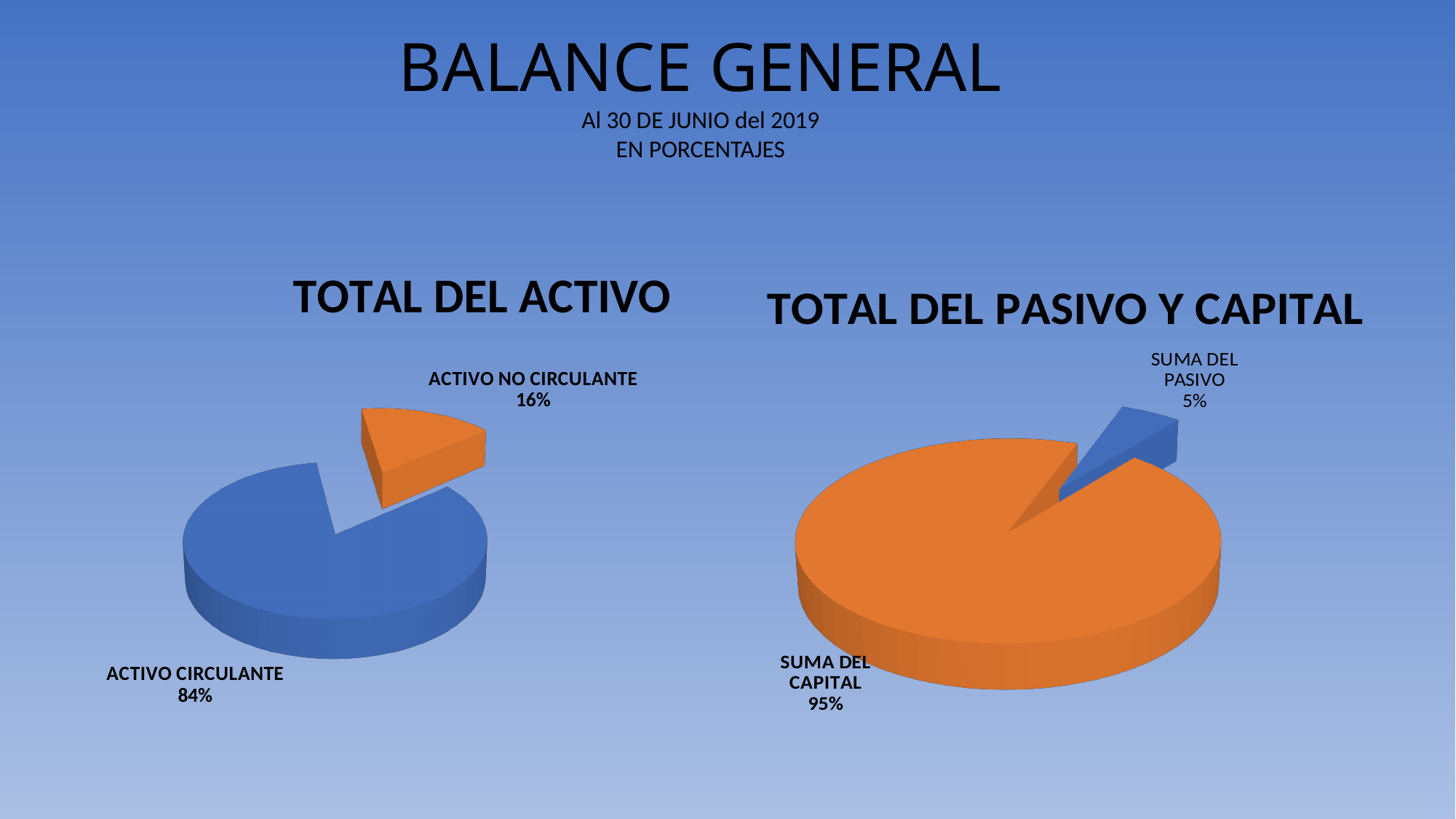
In the 'TOTAL DEL PASIVO Y CAPITAL' chart, what is the value for SUMA DEL PASIVO? 5% In the 'TOTAL DEL PASIVO Y CAPITAL' chart, which is larger, SUMA DEL PASIVO or SUMA DEL CAPITAL? SUMA DEL CAPITAL What kind of chart is the 'TOTAL DEL PASIVO Y CAPITAL' chart? Pie chart In the 'TOTAL DEL PASIVO Y CAPITAL' chart, what is the difference between SUMA DEL CAPITAL and SUMA DEL PASIVO? 90% In the 'TOTAL DEL PASIVO Y CAPITAL' chart, which slice is the smallest? SUMA DEL PASIVO In the 'TOTAL DEL ACTIVO' chart, what is the value for ACTIVO NO CIRCULANTE? 16% In the 'TOTAL DEL PASIVO Y CAPITAL' chart, what is the value for SUMA DEL CAPITAL? 95% In the 'TOTAL DEL ACTIVO' chart, which slice is the largest? ACTIVO CIRCULANTE In the 'TOTAL DEL ACTIVO' chart, what colour is the ACTIVO NO CIRCULANTE slice? Orange How many slices does the 'TOTAL DEL ACTIVO' chart have? 2 In the 'TOTAL DEL ACTIVO' chart, what is the value for ACTIVO CIRCULANTE? 84% In the 'TOTAL DEL ACTIVO' chart, what is the difference between ACTIVO CIRCULANTE and ACTIVO NO CIRCULANTE? 68%